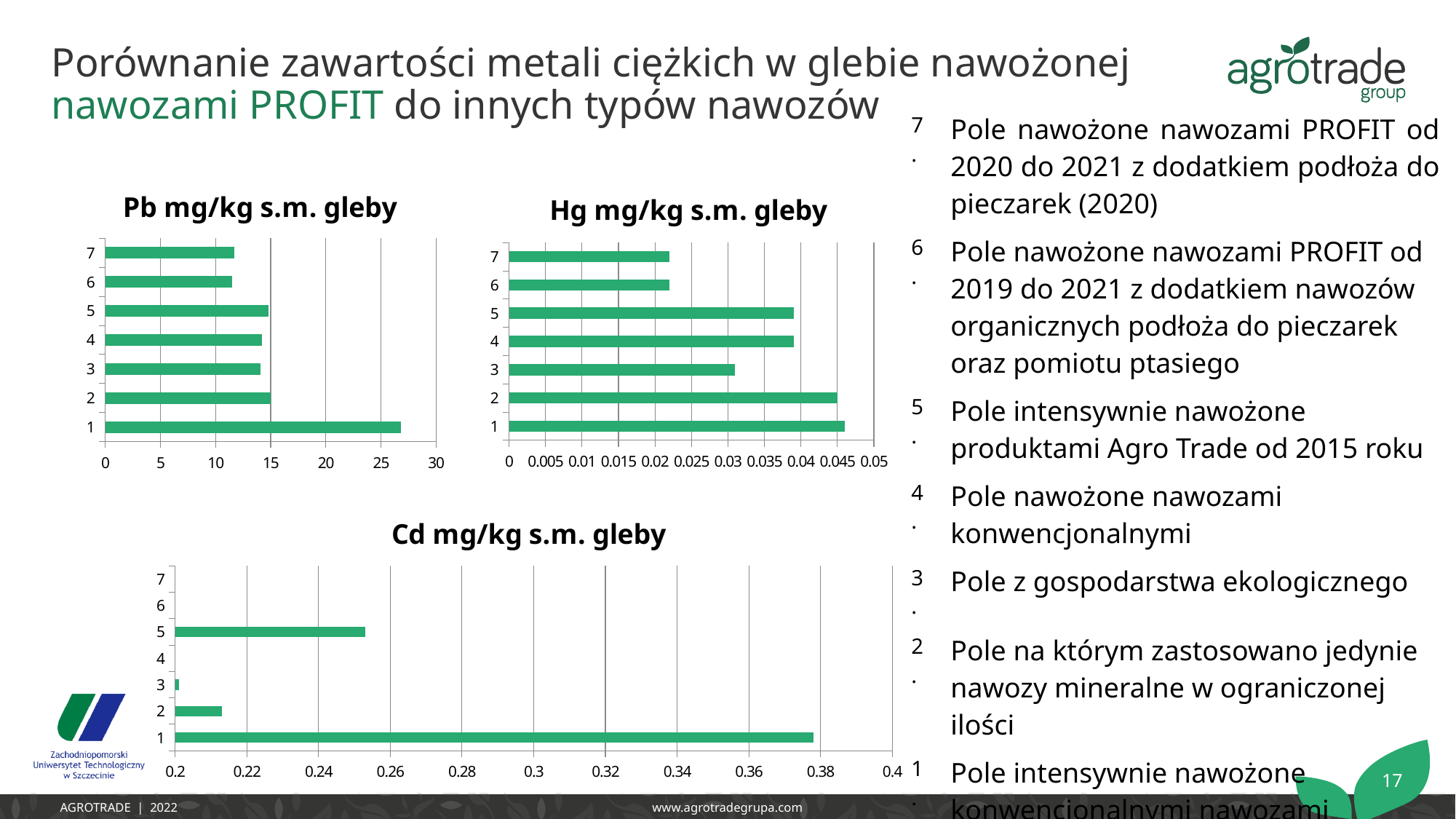
In the 'Pb mg/kg s.m. gleby' chart, is the value for category 6 greater or less than 15? less In the 'Hg mg/kg s.m. gleby' chart, which is larger, the value for category 4 or category 3? 4 How many categories are shown in the 'Hg mg/kg s.m. gleby' chart? 7 In the 'Pb mg/kg s.m. gleby' chart, which category has the highest value? 1 In the 'Cd mg/kg s.m. gleby' chart, which category has the highest value? 1 In the 'Cd mg/kg s.m. gleby' chart, is the value for category 5 greater or less than 0.24? greater In the 'Hg mg/kg s.m. gleby' chart, is the value for category 1 greater or less than 0.04? greater In the 'Pb mg/kg s.m. gleby' chart, which is larger, the value for category 5 or category 7? 5 What type of chart is the 'Pb mg/kg s.m. gleby' chart? bar chart How many charts are shown on the slide? 3